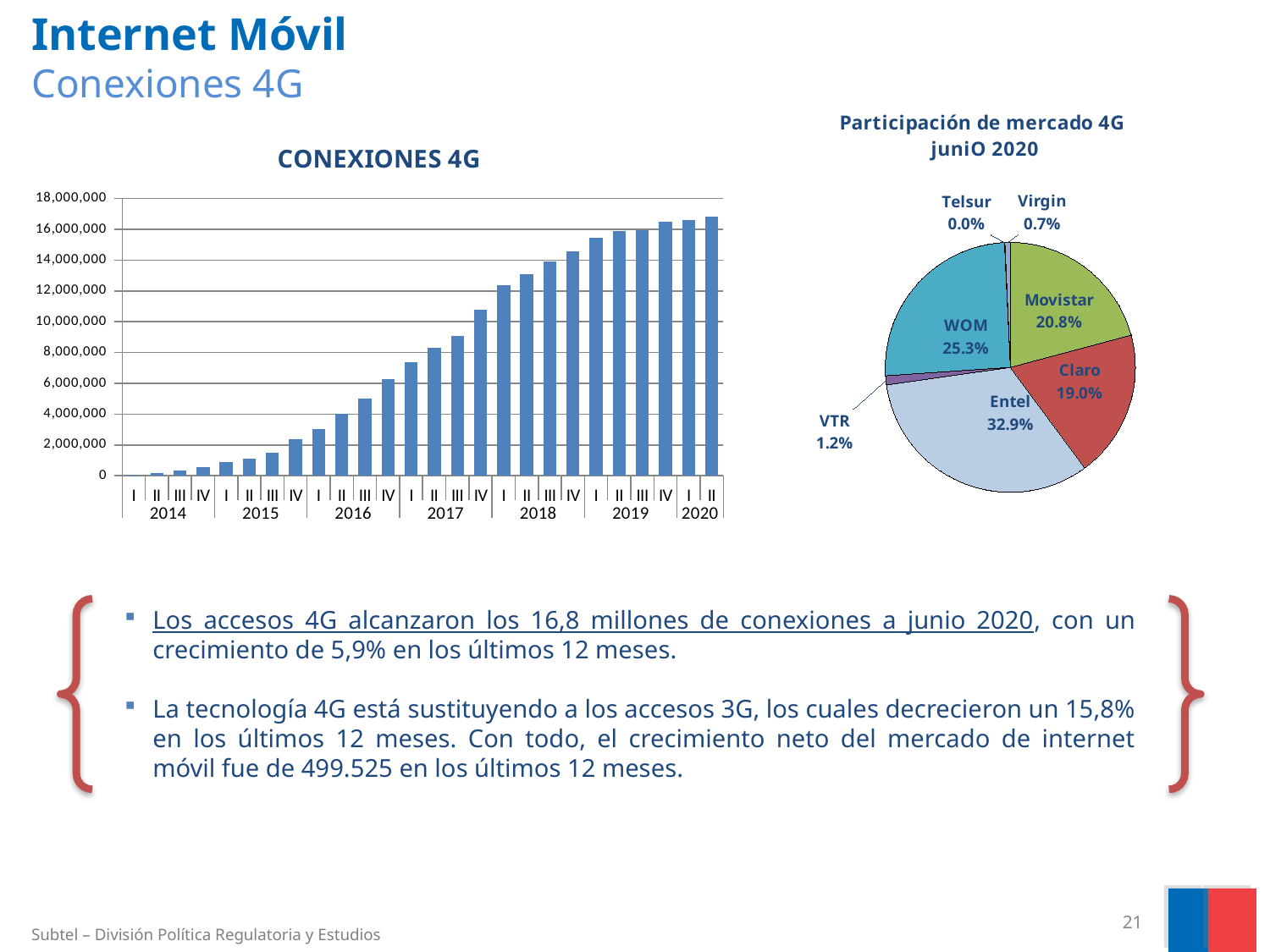
How many operators are shown in the pie chart 'Participación de mercado 4G juniO 2020'? 7 In the pie chart 'Participación de mercado 4G juniO 2020', which has a larger share, WOM or Movistar? WOM In the pie chart 'Participación de mercado 4G juniO 2020', which operator has the largest market share? Entel In the pie chart 'Participación de mercado 4G juniO 2020', what is the difference in percentage points between Movistar's and Claro's shares? 1.8% What kind of chart is 'Participación de mercado 4G juniO 2020'? Pie chart What kind of chart is 'CONEXIONES 4G'? Bar chart In the 'CONEXIONES 4G' chart, is the value for quarter II of 2020 greater or less than 16,000,000? greater In the pie chart 'Participación de mercado 4G juniO 2020', what is WOM's market share? 25.3% In the pie chart 'Participación de mercado 4G juniO 2020', which operator has the smallest market share? Telsur In the 'CONEXIONES 4G' chart, do the values generally rise or fall from 2014 to 2020? Rise In the pie chart 'Participación de mercado 4G juniO 2020', what is Entel's market share? 32.9% In the 'CONEXIONES 4G' chart, is the value for quarter IV of 2014 greater or less than 2,000,000? less